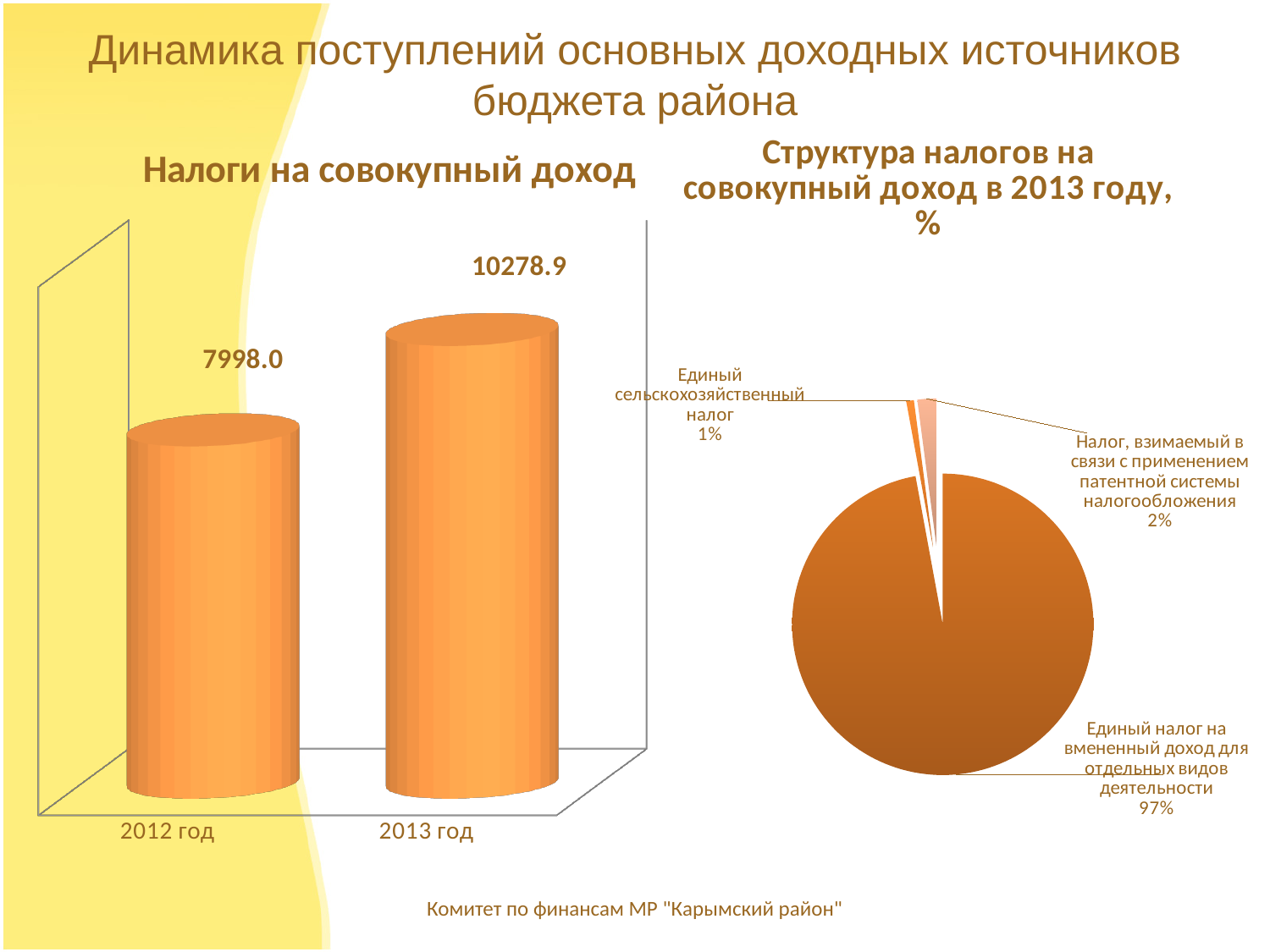
What kind of chart is "Налоги на совокупный доход"? Bar chart In the pie chart "Структура налогов на совокупный доход в 2013 году, %", what share does "Налог, взимаемый в связи с применением патентной системы налогообложения" have? 2% In the pie chart "Структура налогов на совокупный доход в 2013 году, %", which slice is the smallest? Единый сельскохозяйственный налог In the chart "Налоги на совокупный доход", what is the difference between the 2013 год and 2012 год values? 2280.9 How many slices does the pie chart "Структура налогов на совокупный доход в 2013 году, %" have? 3 In the chart "Налоги на совокупный доход", how many bars are plotted? 2 In the chart "Налоги на совокупный доход", which year has the higher value? 2013 год In the chart "Налоги на совокупный доход", what is the value for 2013 год? 10278.9 In the chart "Налоги на совокупный доход", what is the value for 2012 год? 7998.0 In the pie chart "Структура налогов на совокупный доход в 2013 году, %", what share does "Единый налог на вмененный доход для отдельных видов деятельности" have? 97% In the chart "Налоги на совокупный доход", do the values rise or fall from 2012 год to 2013 год? Rise In the pie chart "Структура налогов на совокупный доход в 2013 году, %", what share does "Единый сельскохозяйственный налог" have? 1%